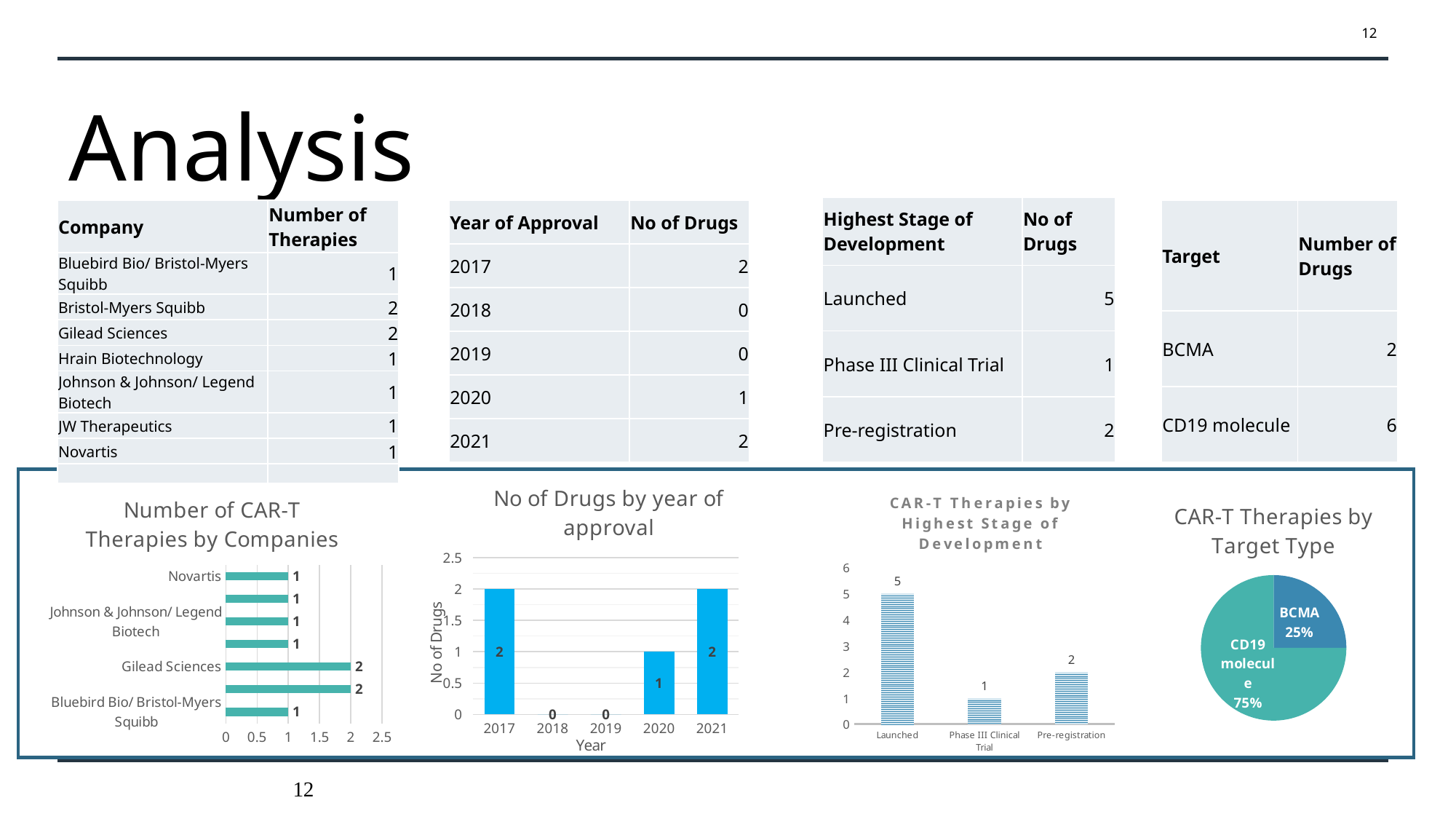
In the 'No of Drugs by year of approval' chart, what is the difference between the values for 2017 and 2020? 1 In the 'Number of CAR-T Therapies by Companies' chart, which is larger, the value for Gilead Sciences or the value for Novartis? Gilead Sciences What kind of chart is 'Number of CAR-T Therapies by Companies'? Bar chart What kind of chart is 'CAR-T Therapies by Target Type'? Pie chart In the 'No of Drugs by year of approval' chart, how many years are shown on the x axis? 5 In the 'Number of CAR-T Therapies by Companies' chart, what is the value for Gilead Sciences? 2 In the 'No of Drugs by year of approval' chart, which years have the highest value? 2017 and 2021 In the 'CAR-T Therapies by Highest Stage of Development' chart, what is the difference between Launched and Pre-registration? 3 In the 'CAR-T Therapies by Highest Stage of Development' chart, what is the value for Launched? 5 In the 'No of Drugs by year of approval' chart, what is the value for 2020? 1 In the 'CAR-T Therapies by Highest Stage of Development' chart, which category has the lowest value? Phase III Clinical Trial In the 'CAR-T Therapies by Target Type' chart, what share does BCMA have? 25%